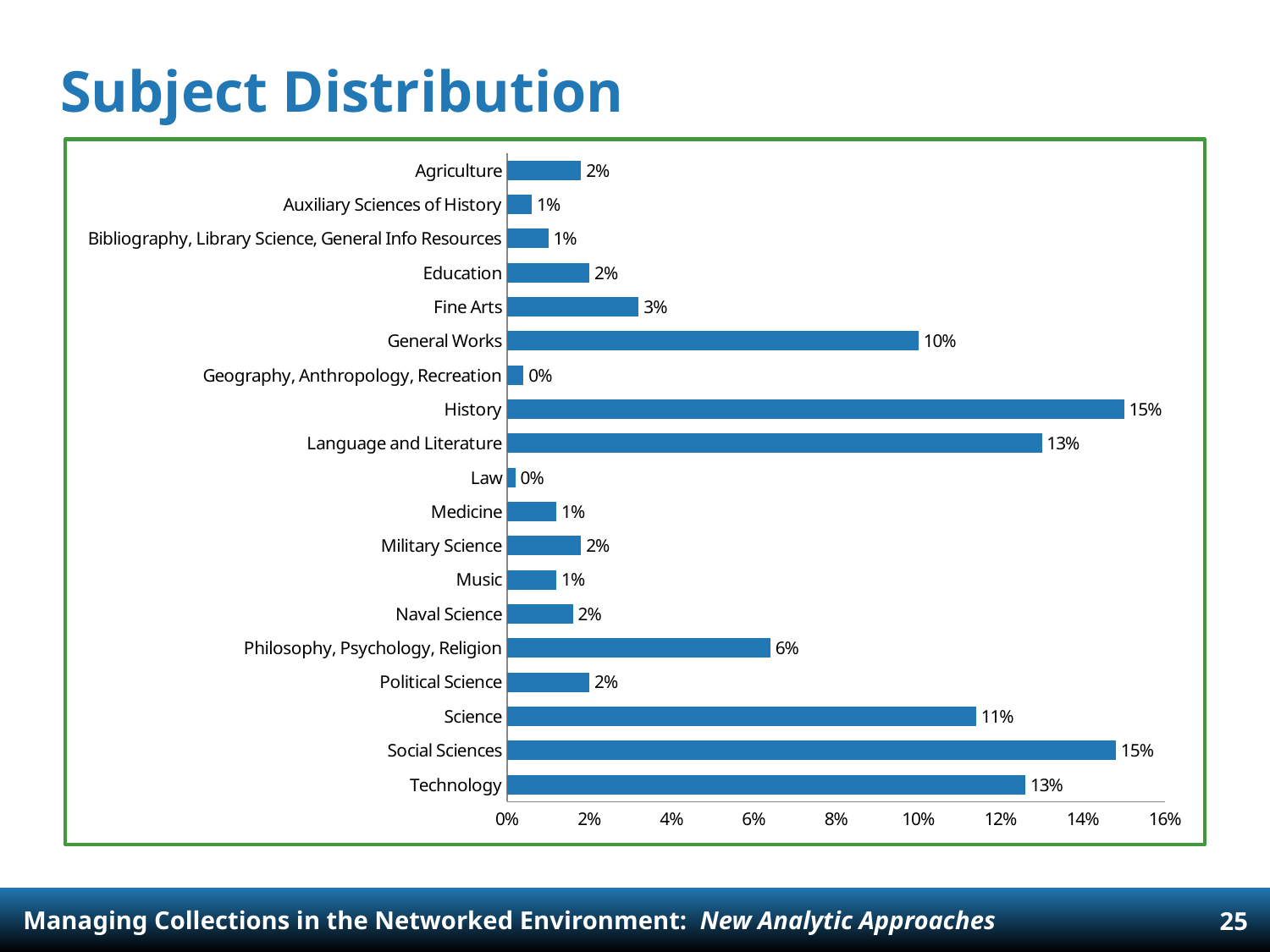
What is the value for Fine Arts? 3% What is the difference between the value for Science and the value for Philosophy, Psychology, Religion? 5% What is the difference between the value for History and the value for General Works? 5% How many categories are shown in the chart? 19 Which is larger, the value for General Works or the value for Fine Arts? General Works Which is larger, the value for Technology or the value for Science? Technology What is the value for Language and Literature? 13% What kind of chart is shown on the slide? Bar chart What is the value for General Works? 10% What is the value for Philosophy, Psychology, Religion? 6% What is the value for Science? 11% What is the title of the slide containing the chart? Subject Distribution